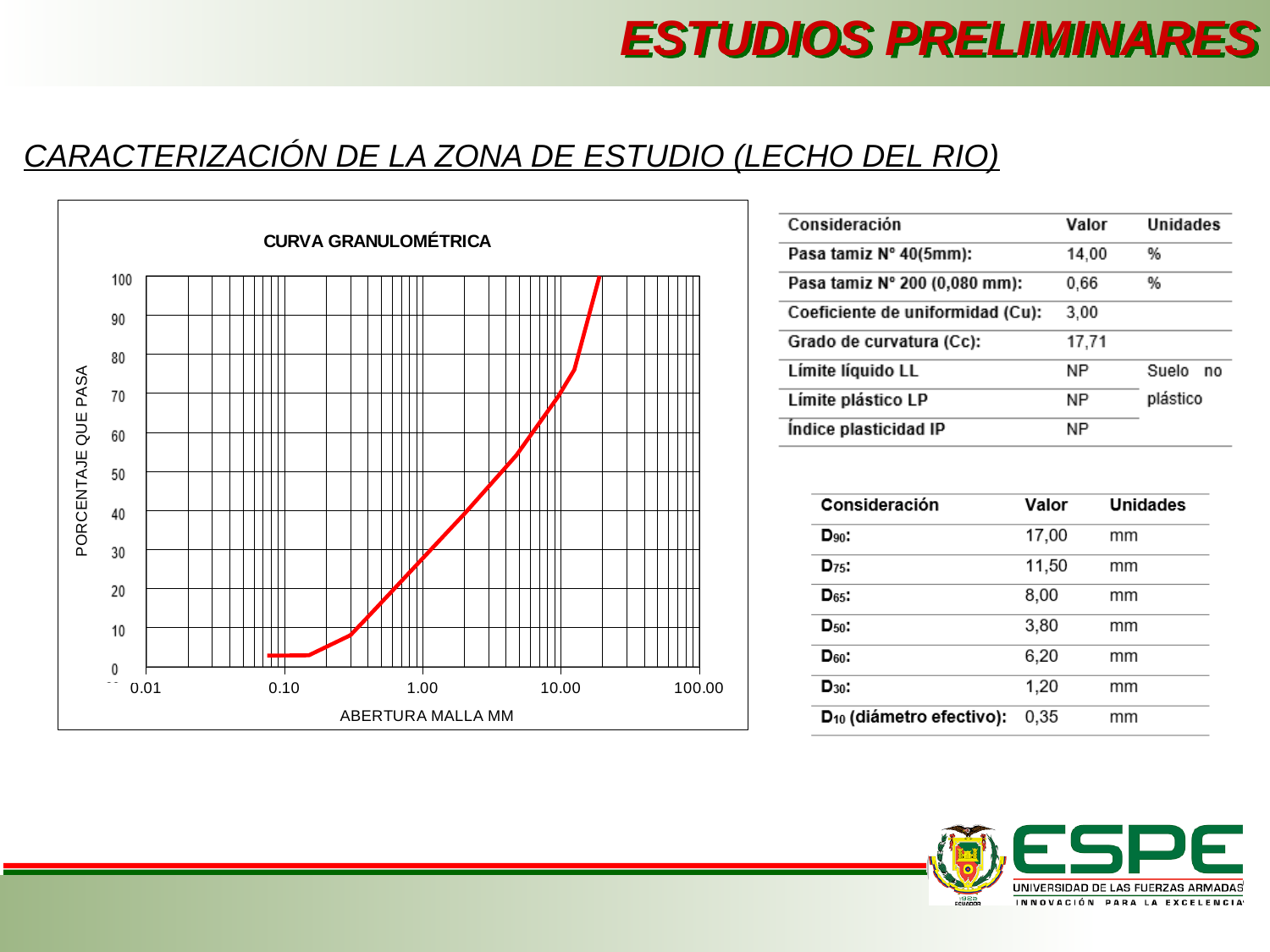
What is the title of the chart on the slide? CURVA GRANULOMÉTRICA Does the curve in the chart rise or fall as the mesh opening (x axis) increases? Rises In the chart, is the percentage passing at a mesh opening of 0.10 mm greater or less than 10? less In the chart, is the percentage passing at a mesh opening of 10.00 mm greater or less than 50? greater In the chart, is the percentage passing at a mesh opening of 1.00 mm greater or less than 50? less What is the highest value shown on the y axis of the chart? 100 What kind of chart is shown on the slide? Line chart What is the label of the x axis of the chart? ABERTURA MALLA MM In the chart, is the percentage passing higher at 10.00 mm or at 1.00 mm? 10.00 mm